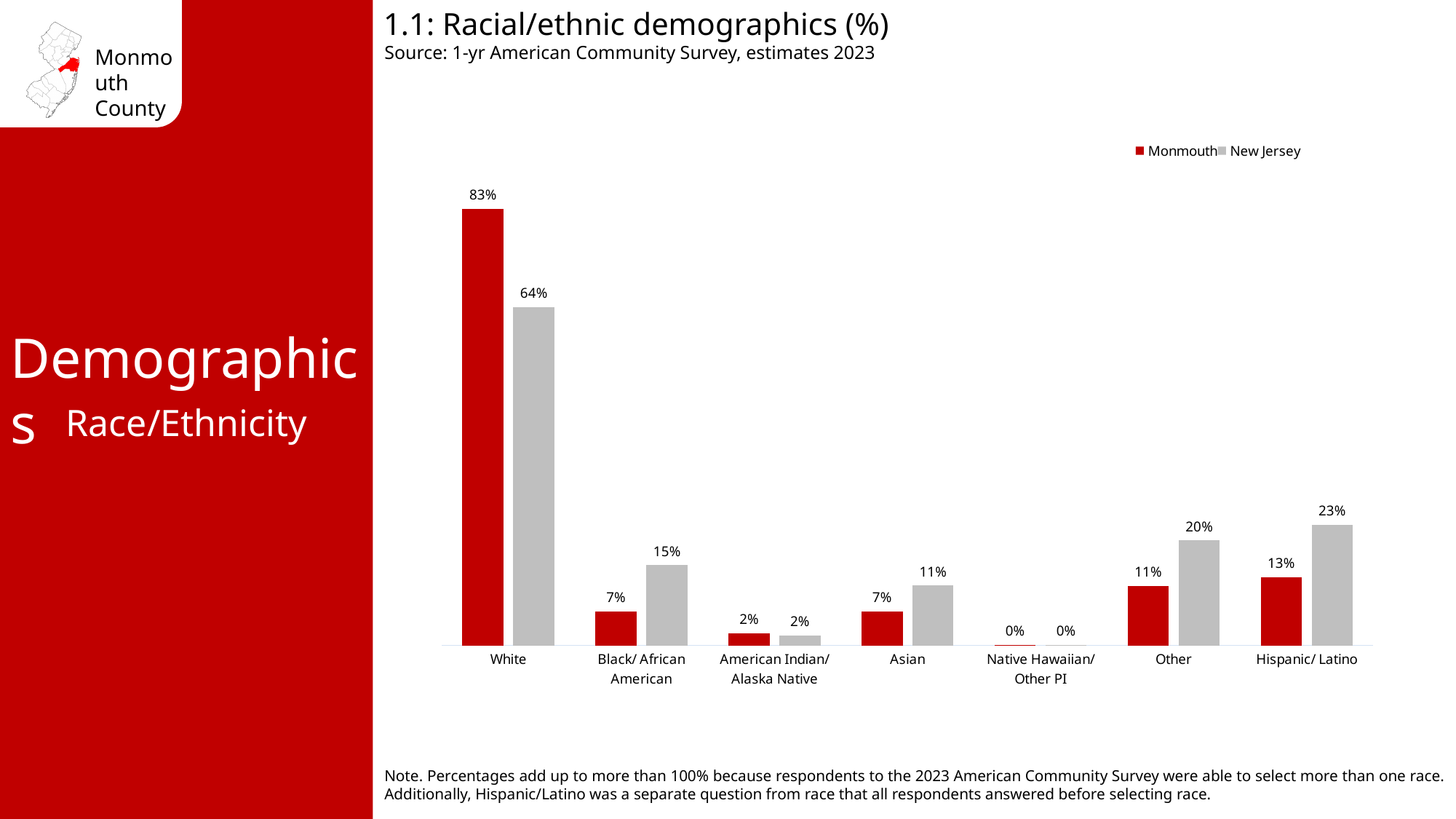
What is the difference between the New Jersey and Monmouth values for Black/ African American? 8% How many series does the legend list? 2 Which category has the lowest New Jersey value? Native Hawaiian/ Other PI What is the New Jersey value for Other? 20% How many categories are shown on the x axis? 7 What is the Monmouth value for Asian? 7% What is the Monmouth value for White? 83% Which is larger for Hispanic/ Latino, the Monmouth value or the New Jersey value? New Jersey What kind of chart is shown on the slide? Bar chart Which category has the highest Monmouth value? White What is the difference between the Monmouth and New Jersey values for White? 19% What is the New Jersey value for Hispanic/ Latino? 23%